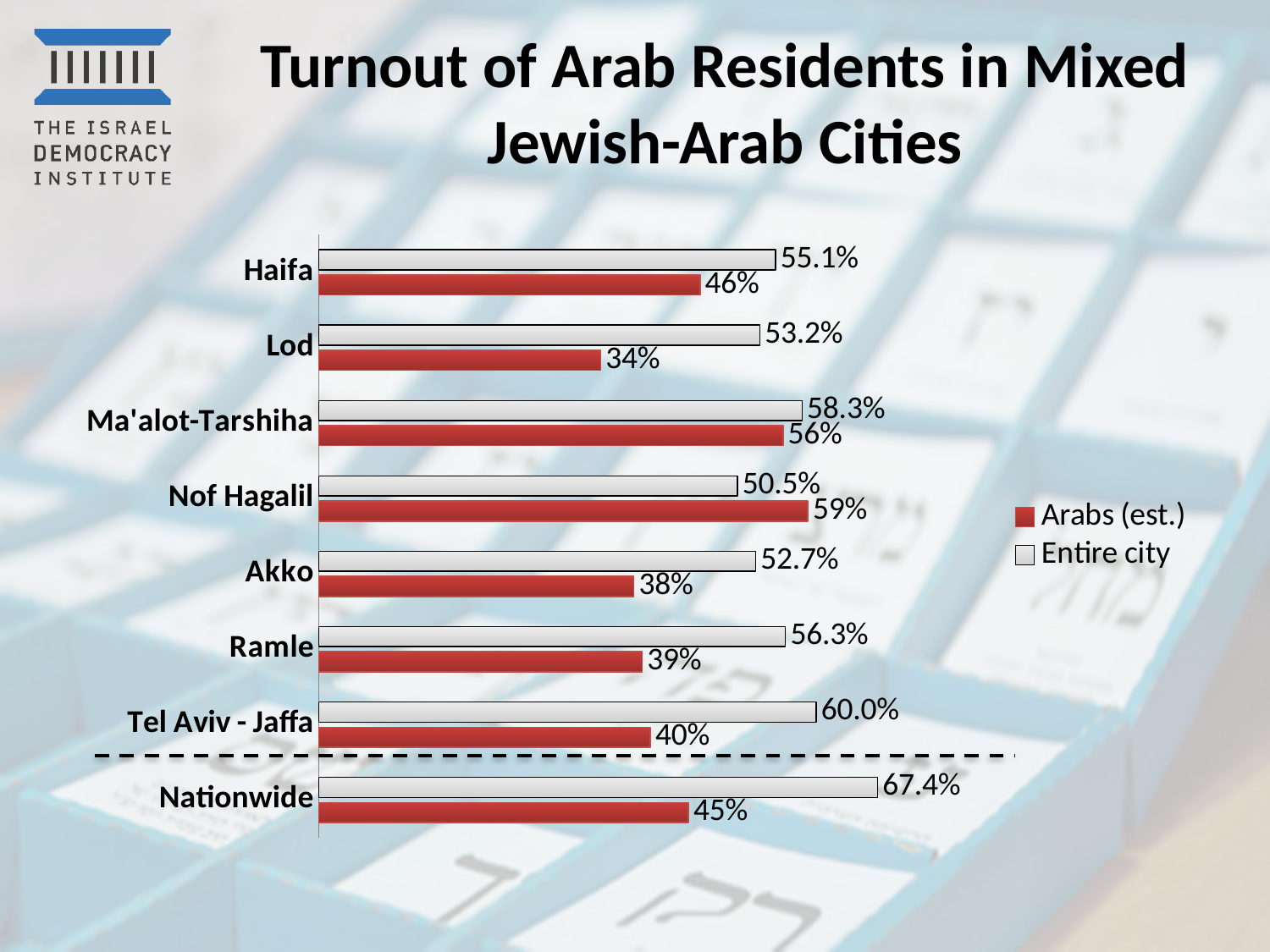
Which category has the lowest estimated Arab turnout? Lod What is the difference between the Entire city turnout and the estimated Arab turnout in Lod? 19.2% Which category has the highest Entire city turnout? Nationwide What is the estimated Arab turnout in Haifa? 46% How many series does the legend list? 2 How many categories are shown on the chart? 8 In Nof Hagalil, which is larger: the estimated Arab turnout or the Entire city turnout? Arabs (est.) What colour are the bars for the Arabs (est.) series? Red What kind of chart is shown on the slide? Bar chart Which category has the highest estimated Arab turnout? Nof Hagalil What is the Entire city turnout for Lod? 53.2% What is the Entire city turnout for Tel Aviv - Jaffa? 60.0%